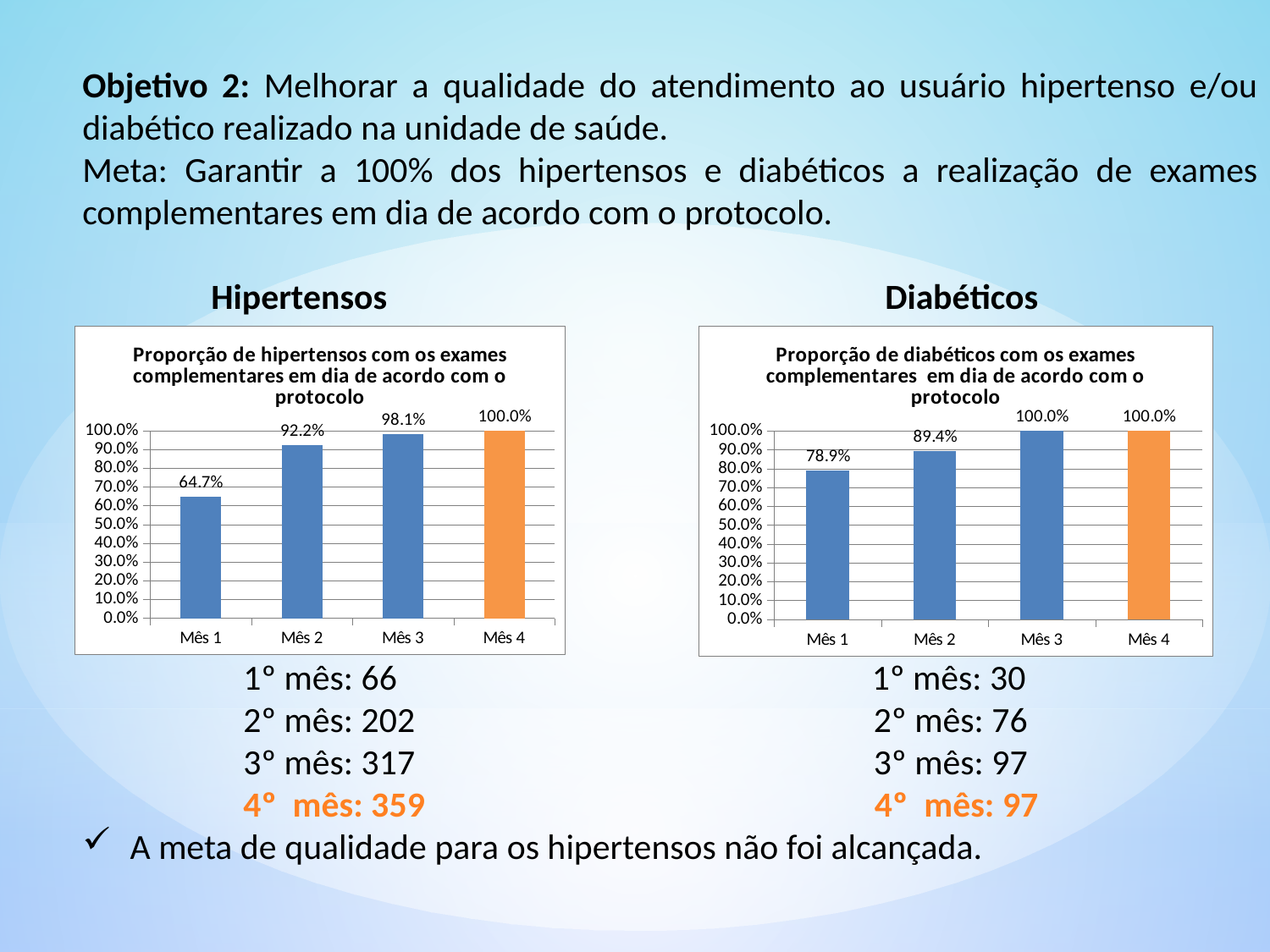
In the Hipertensos chart, what is the value for Mês 3? 98.1% In the Hipertensos chart, what is the difference between Mês 2 and Mês 1? 27.5% Which is larger: Mês 1 in the Hipertensos chart or Mês 1 in the Diabéticos chart? Mês 1 in the Diabéticos chart In the Diabéticos chart, which month has the lowest value? Mês 1 In the Hipertensos chart, do the values rise or fall from Mês 1 to Mês 4? rise In the Diabéticos chart, what is the difference between Mês 3 and Mês 2? 10.6% In the Hipertensos chart, what is the value for Mês 1? 64.7% In the Diabéticos chart, what is the value for Mês 2? 89.4% How many months are shown in the Hipertensos chart? 4 In the Diabéticos chart, what is the value for Mês 1? 78.9% In the Hipertensos chart, which month has the lowest value? Mês 1 In the Hipertensos chart, which month has the highest value? Mês 4